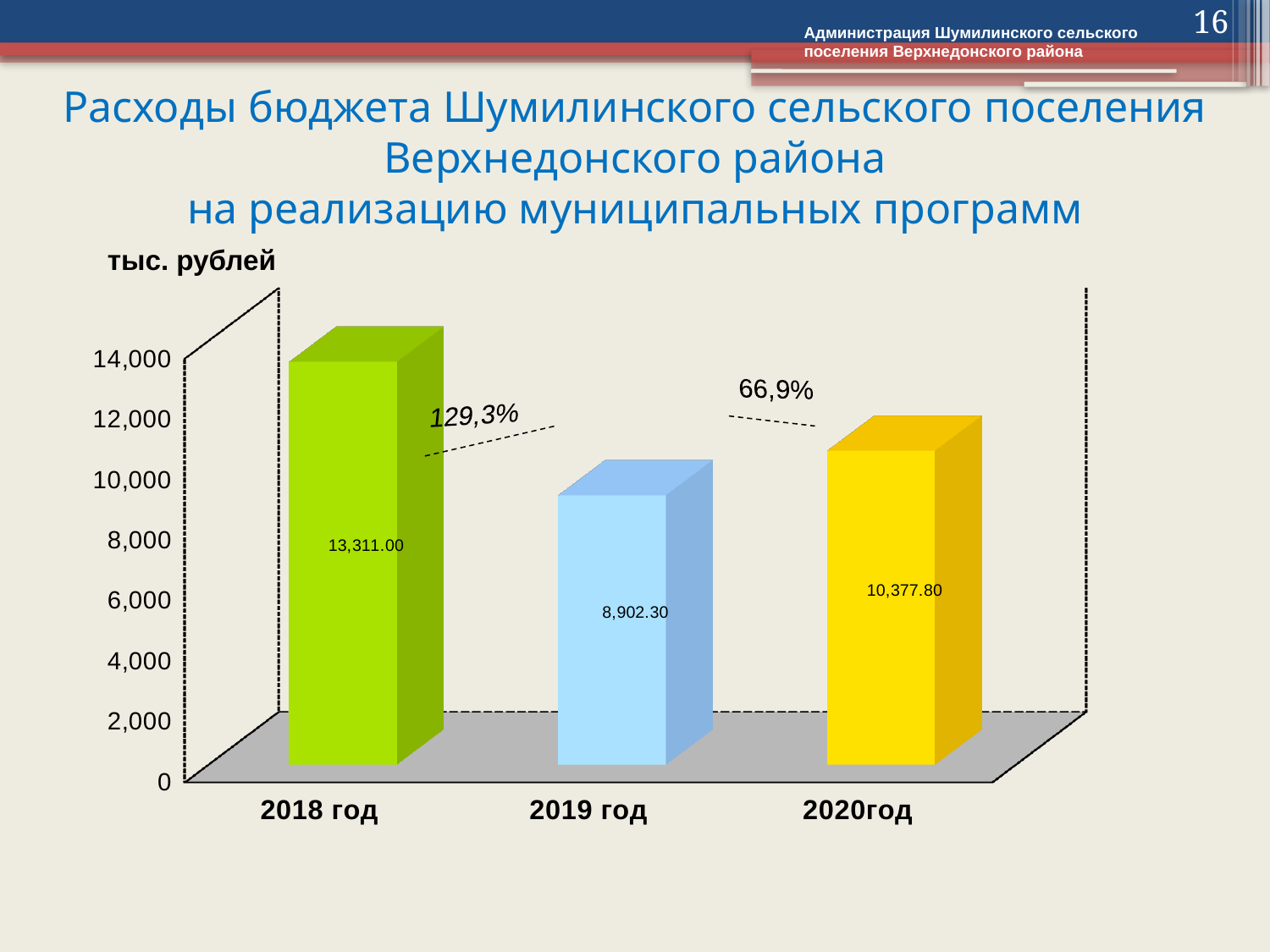
What is the value for 2019 год? 8,902.30 How many years are shown on the chart? 3 What unit of measurement is indicated above the chart? тыс. рублей What kind of chart is shown on the slide? bar chart What is the difference between the values for 2018 год and 2019 год? 4,408.70 What is the value for 2018 год? 13,311.00 Which is larger, the value for 2020год or the value for 2019 год? 2020год What is the difference between the values for 2020год and 2019 год? 1,475.50 Which year has the highest value? 2018 год Do the values rise or fall from 2018 год to 2019 год? fall What is the value for 2020год? 10,377.80 Which year has the lowest value? 2019 год